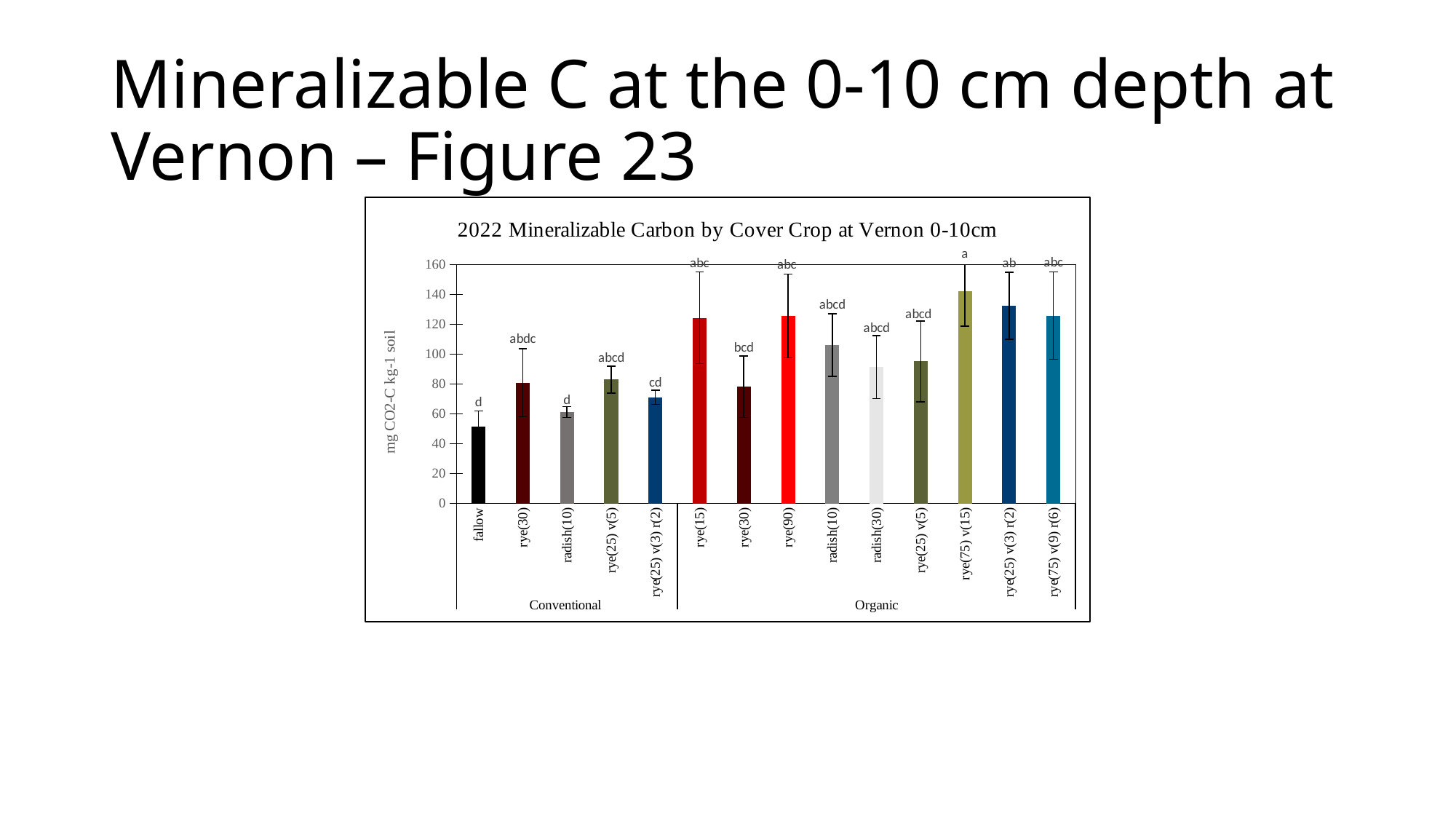
What kind of chart is shown on the slide? bar chart Which is larger, the value for rye(15) or the value for rye(30) in the Organic group? rye(15) Is the value for rye(15) in the Organic group greater or less than 120? greater What are the two management groups labelled along the x axis? Conventional and Organic How many bars (cover crop treatments) are plotted in the chart? 14 Which is larger, the value for fallow or the value for radish(10) in the Conventional group? radish(10) (Conventional) Is the value for rye(30) in the Conventional group greater or less than 100? less Which treatment has the highest mineralizable carbon value? rye(75) v(15) (Organic) Which treatment has the lowest mineralizable carbon value? fallow Is the value for radish(10) in the Organic group greater or less than 100? greater What is the title of the chart? 2022 Mineralizable Carbon by Cover Crop at Vernon 0-10cm